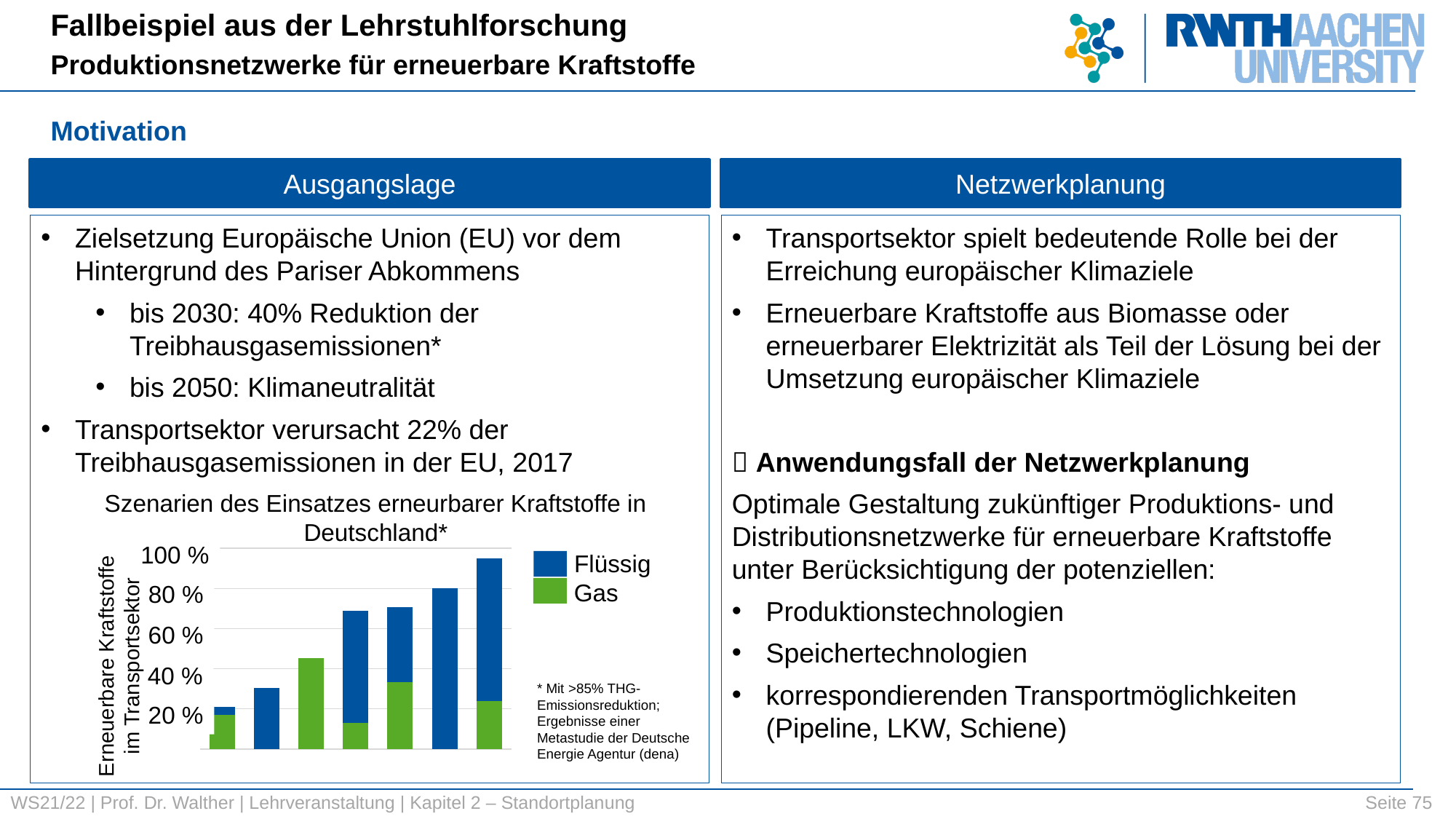
Which two series are listed in the chart's legend? Flüssig and Gas How many series does the chart's legend list? 2 Is the total value of the fourth bar from the left greater or less than 60 %? greater Which bar has the largest Gas (green) segment? the third bar from the left What is the title of the chart? Szenarien des Einsatzes erneurbarer Kraftstoffe in Deutschland* What kind of chart is shown on the slide? stacked bar chart Is the total value of the third bar from the left greater or less than 60 %? less Which bar has the highest total value, the leftmost or the rightmost? the rightmost Which colour represents Flüssig in the chart? blue Is the total value of the rightmost bar greater or less than 80 %? greater How many bars does the chart show? 7 Do the total bar heights generally rise or fall from left to right? rise